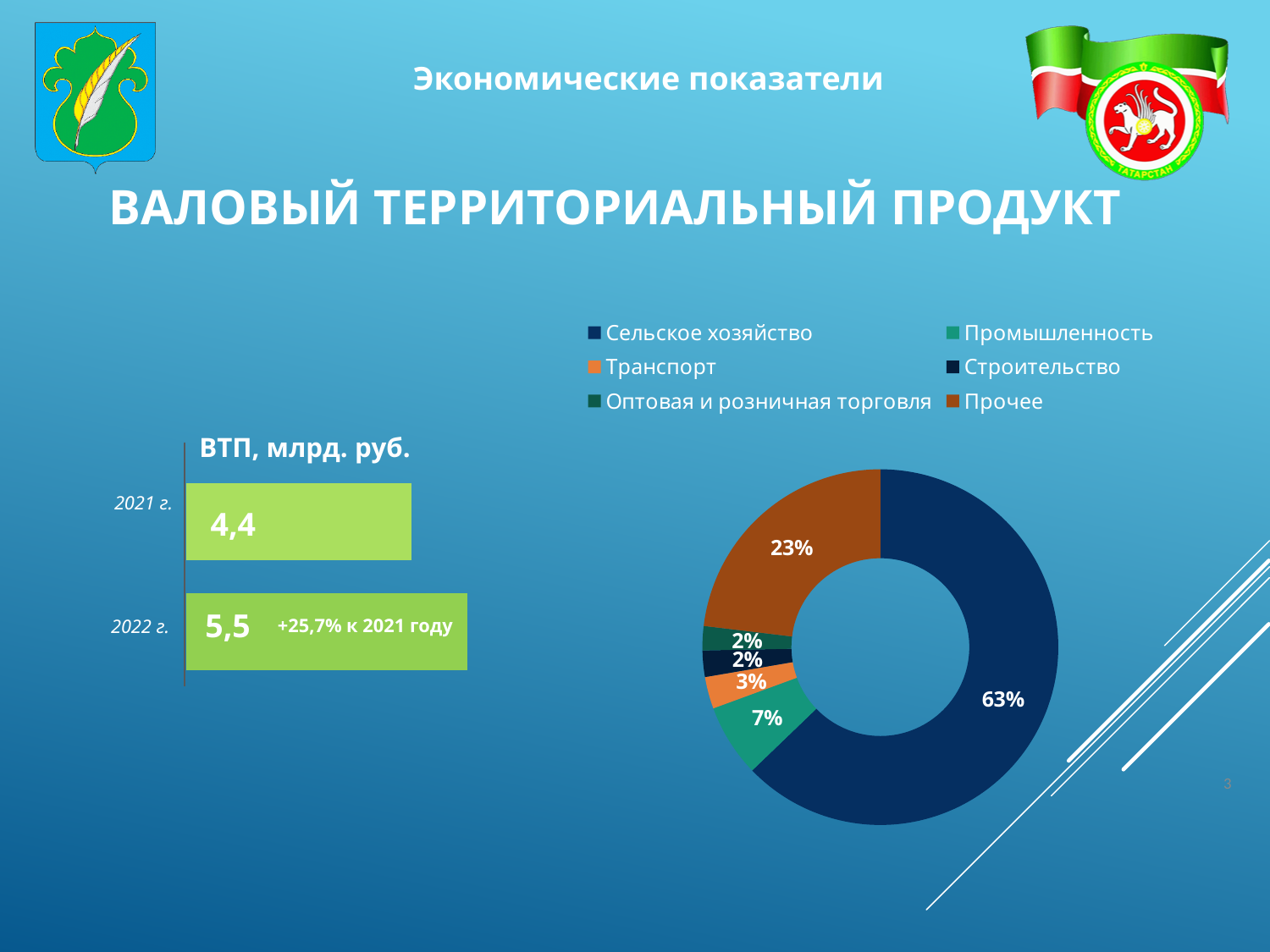
In the bar chart 'ВТП, млрд. руб.', what is the value for 2022 г.? 5,5 In the bar chart 'ВТП, млрд. руб.', what is the difference between the 2022 г. and 2021 г. values? 1,1 In the doughnut chart on the right, which category has the largest share? Сельское хозяйство How many categories does the legend of the doughnut chart on the right list? 6 In the doughnut chart on the right, what share does Сельское хозяйство have? 63% What type of chart is the chart titled 'ВТП, млрд. руб.'? Bar chart In the doughnut chart on the right, what is the difference between the shares of Прочее and Промышленность? 16% In the bar chart 'ВТП, млрд. руб.', what is the value for 2021 г.? 4,4 In the bar chart 'ВТП, млрд. руб.', what percentage change relative to 2021 is shown next to the 2022 г. bar? +25,7% к 2021 году In the doughnut chart on the right, what share does Промышленность have? 7% In the doughnut chart on the right, what share does Прочее have? 23% In the bar chart 'ВТП, млрд. руб.', which year has the higher value, 2021 г. or 2022 г.? 2022 г.